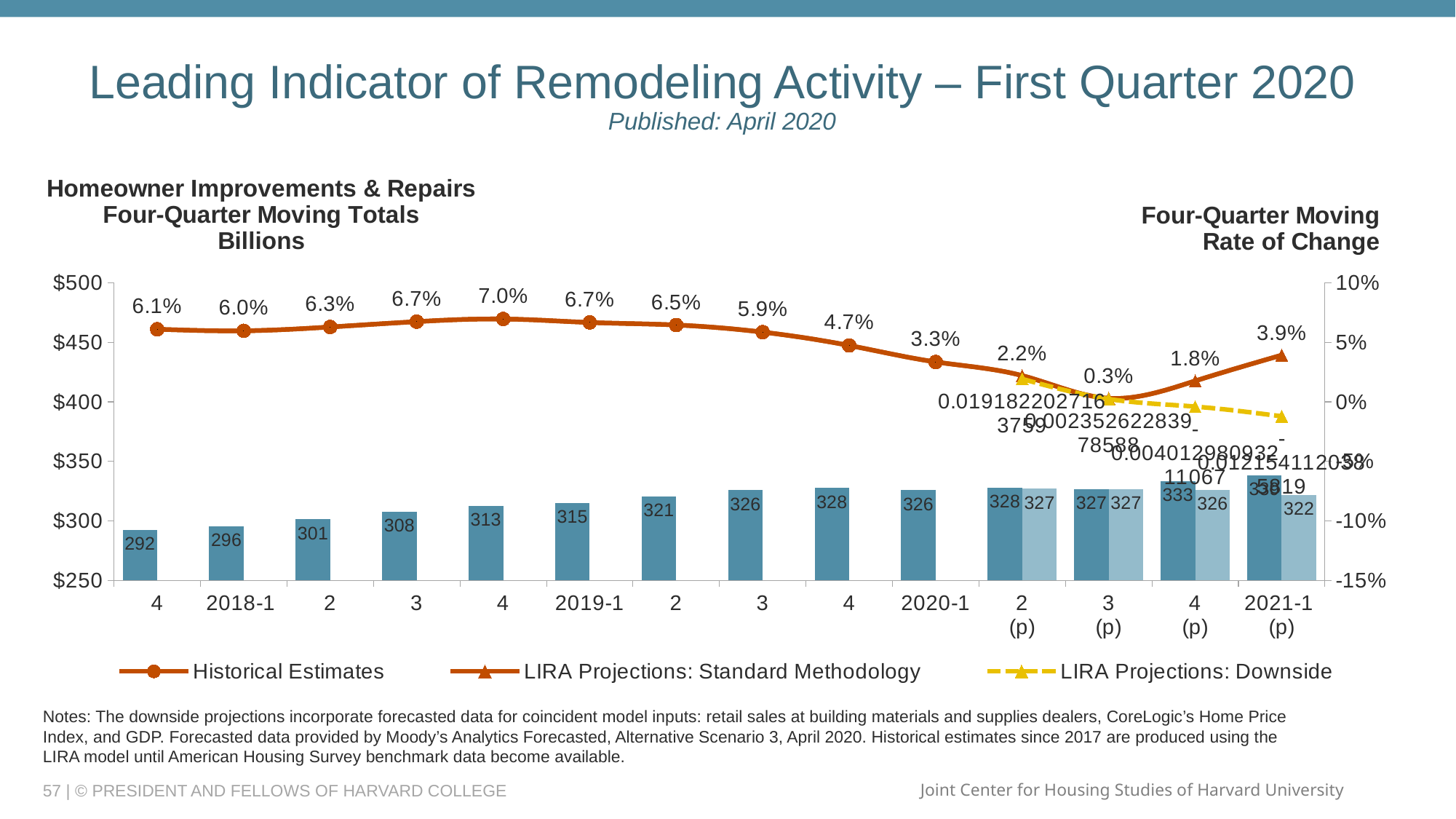
How many quarters are shown along the x axis of the chart? 14 What is the difference between the bar value for quarter 2 of 2019 (321) and the bar value for quarter 2 of 2018 (301)? 20 Is the bar value for 2020-1 greater or less than $300? greater Does the Historical Estimates rate of change rise or fall from quarter 4 of 2018 to 2020-1? Falls What is the four-quarter moving rate of change shown for 2019-1 on the Historical Estimates line? 6.7% What is the lowest four-quarter moving total labeled on any bar in the chart? 292 What rate of change does the LIRA Projections: Standard Methodology line show for 2021-1 (p)? 3.9% How many series does the legend list? 3 What is the four-quarter moving total (billions) shown by the bar for quarter 3 of 2018? 308 What kind of chart is shown on the slide? Combination bar and line chart What is the highest rate of change value labeled on the Historical Estimates line? 7.0% For 2020-4 (p), which bar is larger: the standard methodology bar (333) or the downside bar (326)? Standard methodology (333)